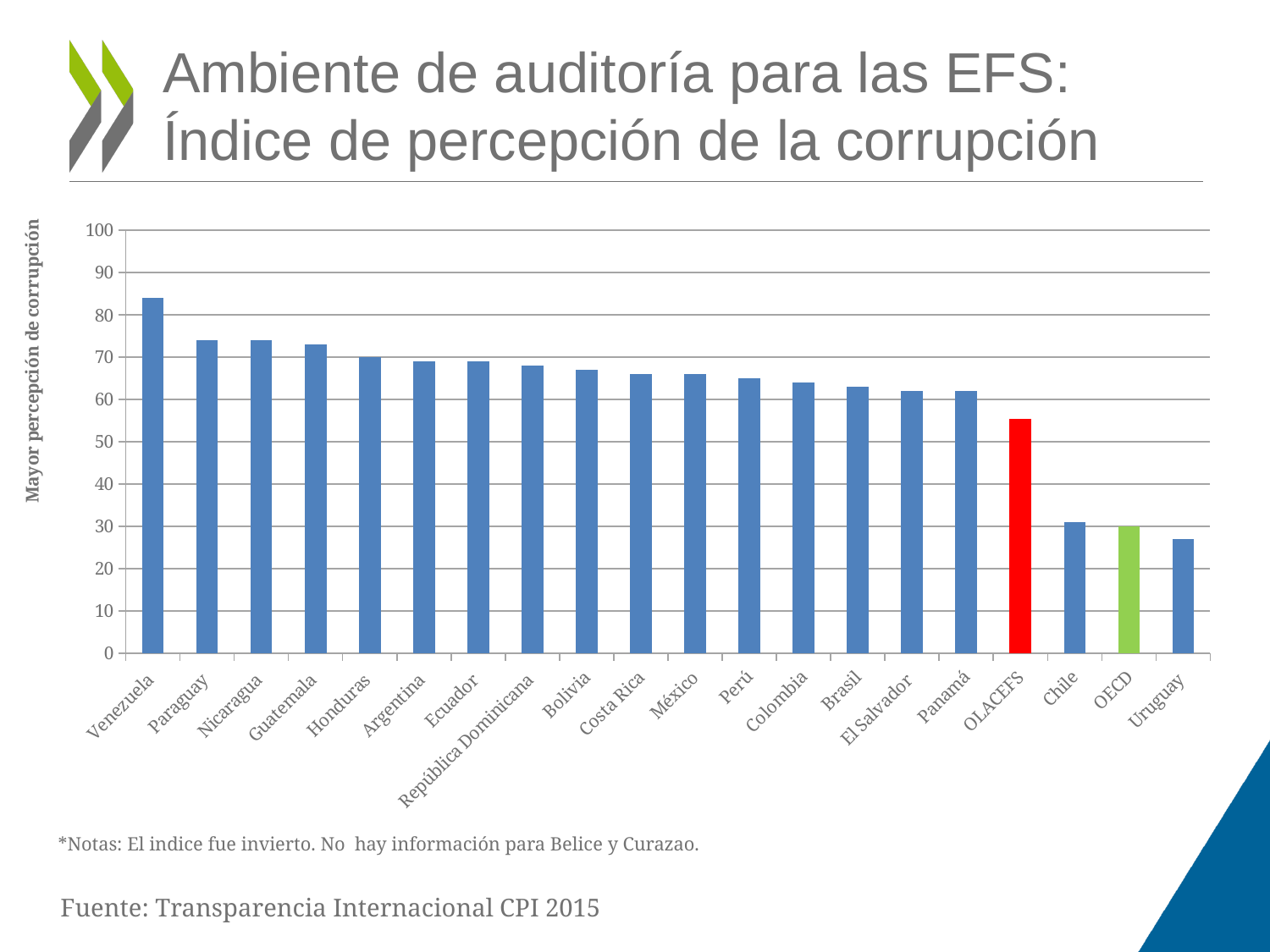
Which is larger, the value for Venezuela or the value for Paraguay? Venezuela How many categories are plotted along the x axis? 20 Is the value for OLACEFS greater or less than 50? greater Is the value for Venezuela greater or less than 80? greater Which category has the highest value in the chart? Venezuela Is the value for Paraguay greater or less than 70? greater Which is larger, the value for OLACEFS or the value for Chile? OLACEFS What kind of chart is shown on the slide? bar chart Which category has the lowest value in the chart? Uruguay Do the values generally rise or fall from left to right along the x axis? fall What colour is the bar for OLACEFS? red